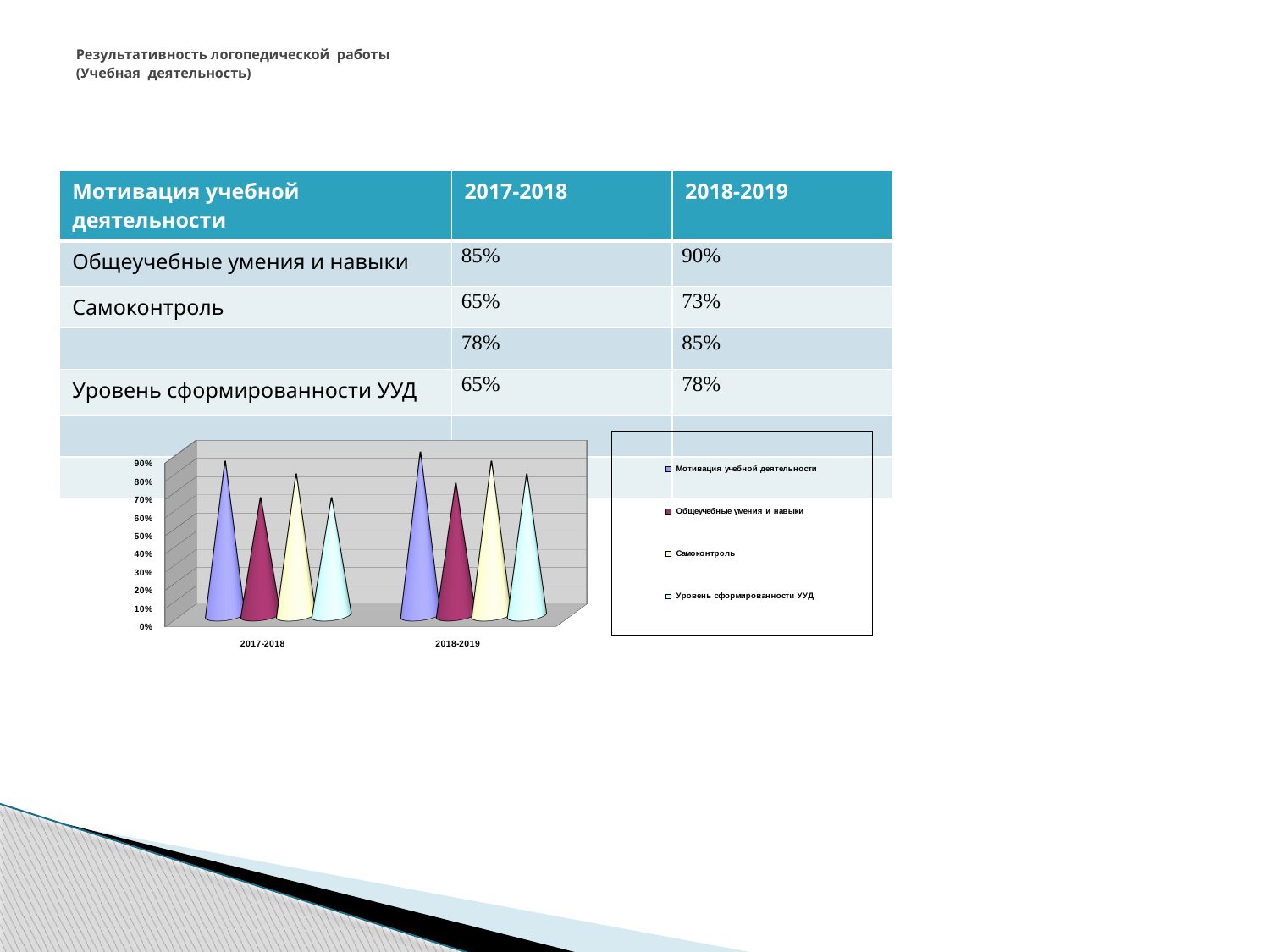
In the chart, does the value for Мотивация учебной деятельности rise or fall from 2017-2018 to 2018-2019? rise What is the highest tick label shown on the chart's vertical axis? 90% How many categories are shown on the x axis of the chart? 2 What kind of chart is shown on the slide? bar chart Which series has the highest value in the 2018-2019 category of the chart? Мотивация учебной деятельности In the chart, is the value for Общеучебные умения и навыки in 2017-2018 greater or less than 70%? less In the chart, is the value for Мотивация учебной деятельности in 2017-2018 greater or less than 80%? greater In the chart, is the value for Самоконтроль in 2018-2019 greater or less than 80%? greater In the chart, which is larger in 2017-2018: Мотивация учебной деятельности or Общеучебные умения и навыки? Мотивация учебной деятельности How many series does the chart legend list? 4 Which series has the highest value in the 2017-2018 category of the chart? Мотивация учебной деятельности